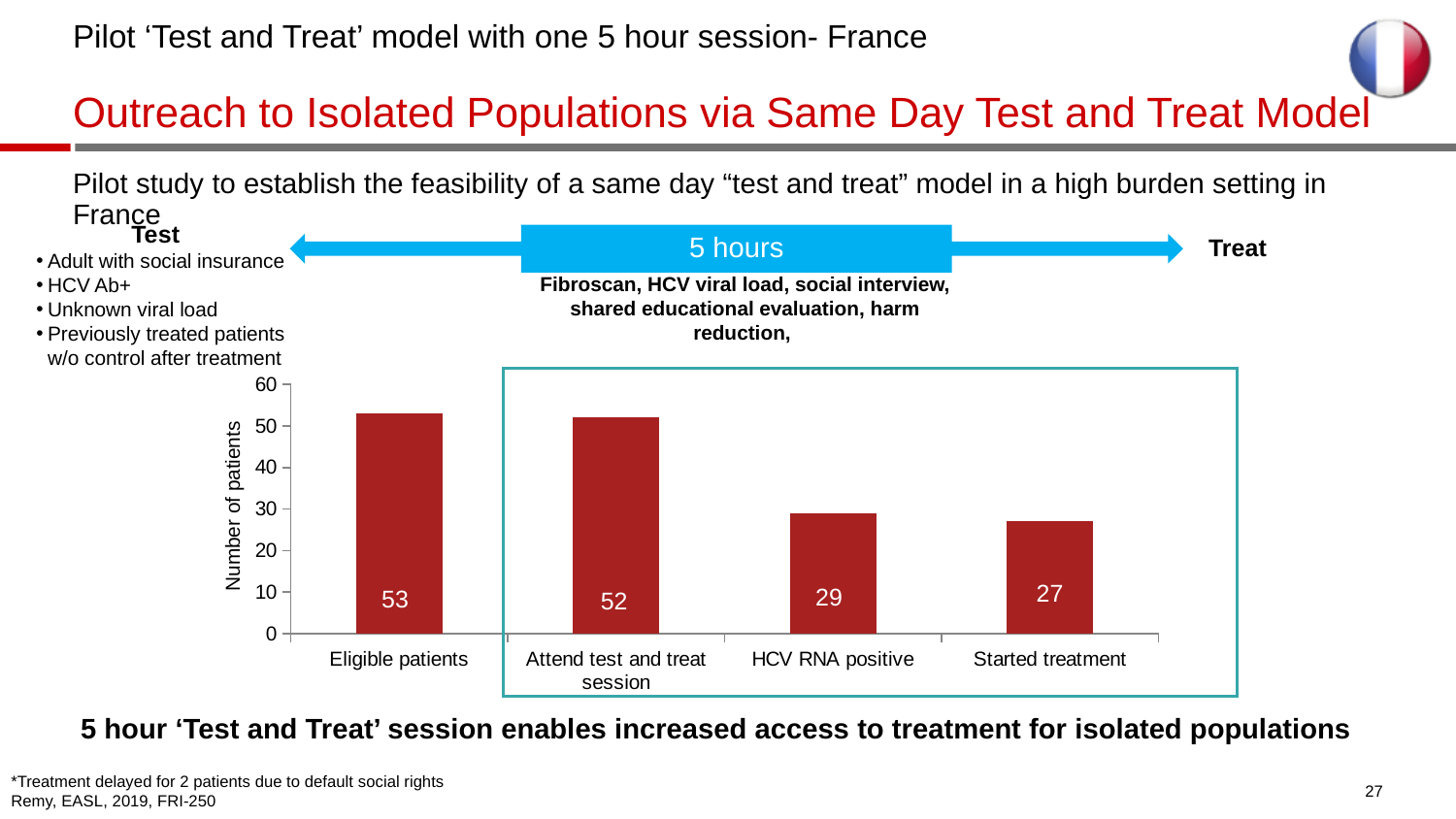
What is the difference between the number of eligible patients and the number who started treatment? 26 How many patients started treatment? 27 How many patients were HCV RNA positive? 29 How many categories are shown on the x axis of the chart? 4 What is the difference between the number of HCV RNA positive patients and the number who started treatment? 2 Which is larger: the number of patients who attended the test and treat session or the number who were HCV RNA positive? Attend test and treat session Which category has the highest number of patients? Eligible patients Which category has the lowest number of patients? Started treatment What type of chart is shown on the slide? Bar chart How many eligible patients are shown in the chart? 53 What is the label of the y axis of the chart? Number of patients What is the number of patients who attended the test and treat session? 52